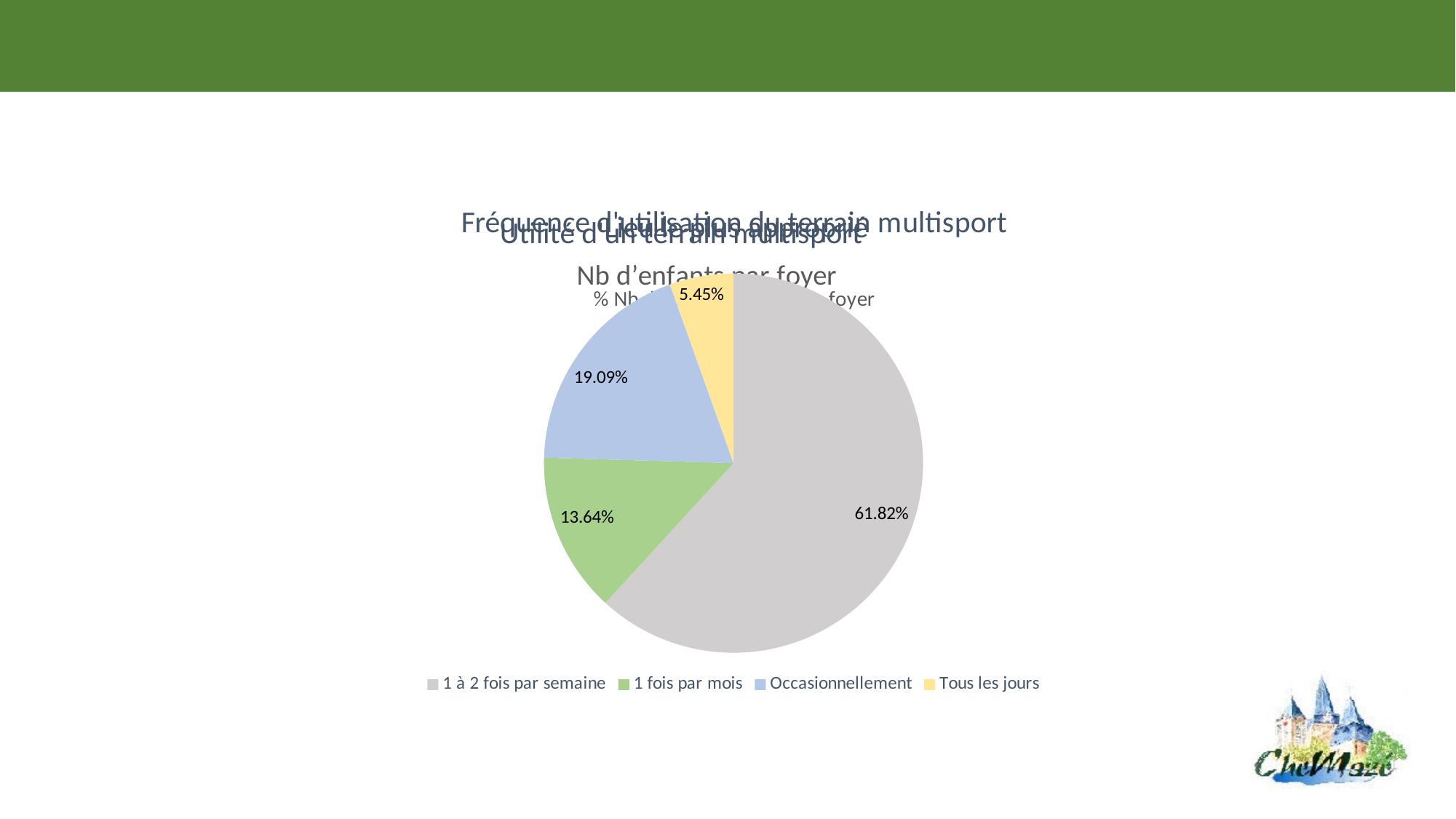
Which is larger, the slice for "Occasionnellement" or the slice for "1 fois par mois"? Occasionnellement What share of the pie does "1 fois par mois" represent? 13.64% What is the difference in percentage points between the "1 à 2 fois par semaine" slice and the "Occasionnellement" slice? 42.73 Which category has the smallest slice of the pie? Tous les jours Which category has the largest slice of the pie? 1 à 2 fois par semaine How many categories does the legend of the pie chart list? 4 What is the difference in percentage points between the "1 fois par mois" slice and the "Tous les jours" slice? 8.19 What kind of chart is shown on the slide? pie chart What share of the pie does "1 à 2 fois par semaine" represent? 61.82% What share of the pie does "Occasionnellement" represent? 19.09% What share of the pie does "Tous les jours" represent? 5.45% What colour is the slice for "Tous les jours"? yellow